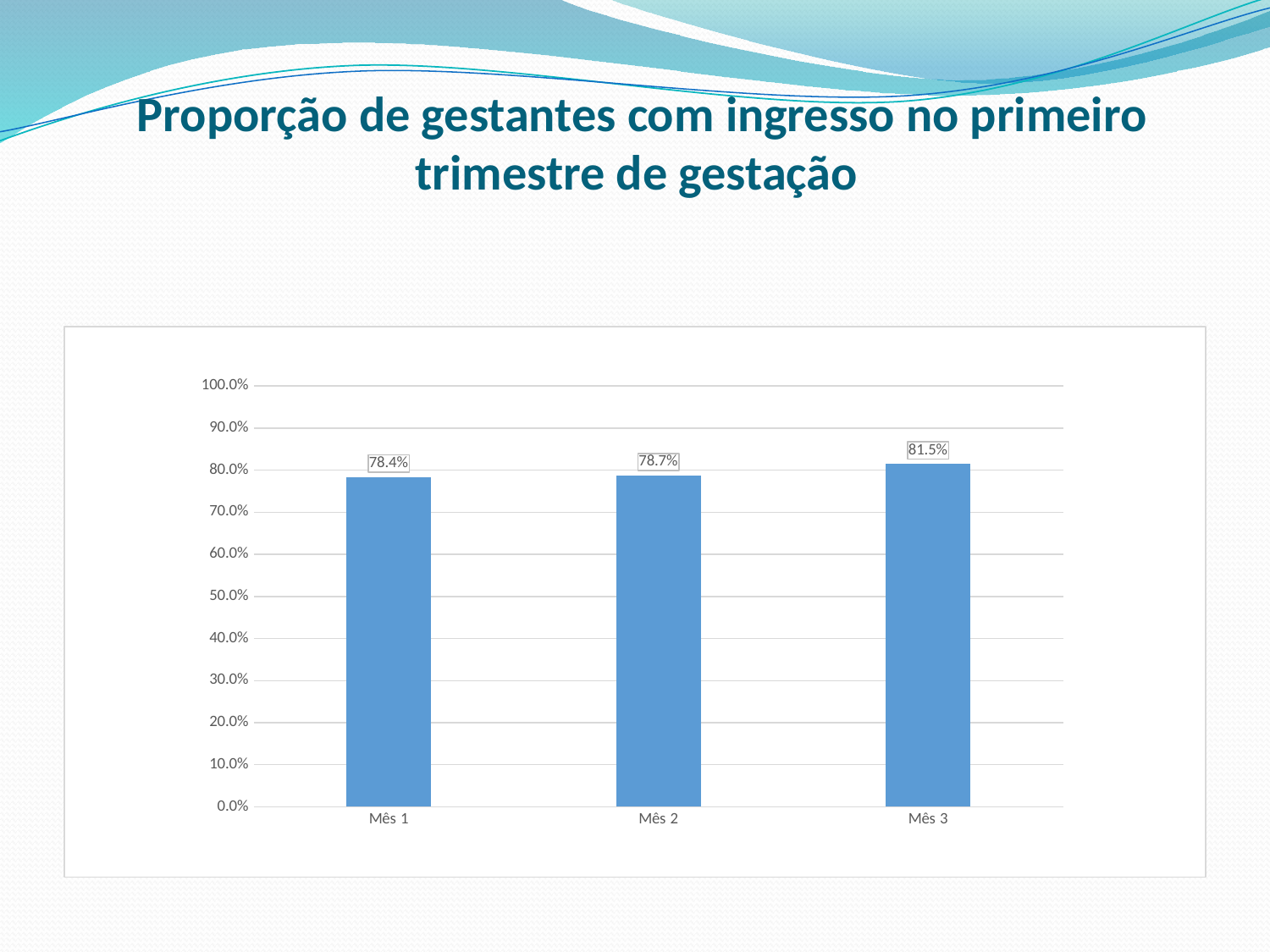
Which is larger, the value for Mês 3 or the value for Mês 2? Mês 3 Which month has the lowest value? Mês 1 Do the values rise or fall from Mês 1 to Mês 3? rise What is the value for Mês 1? 78.4% Which month has the highest value? Mês 3 What is the difference between the values for Mês 3 and Mês 2? 2.8% What is the value for Mês 2? 78.7% What is the difference between the values for Mês 3 and Mês 1? 3.1% What is the value for Mês 3? 81.5% What kind of chart is shown on the slide? bar chart Is the value for Mês 1 greater or less than 80.0%? less How many categories are shown on the x axis? 3